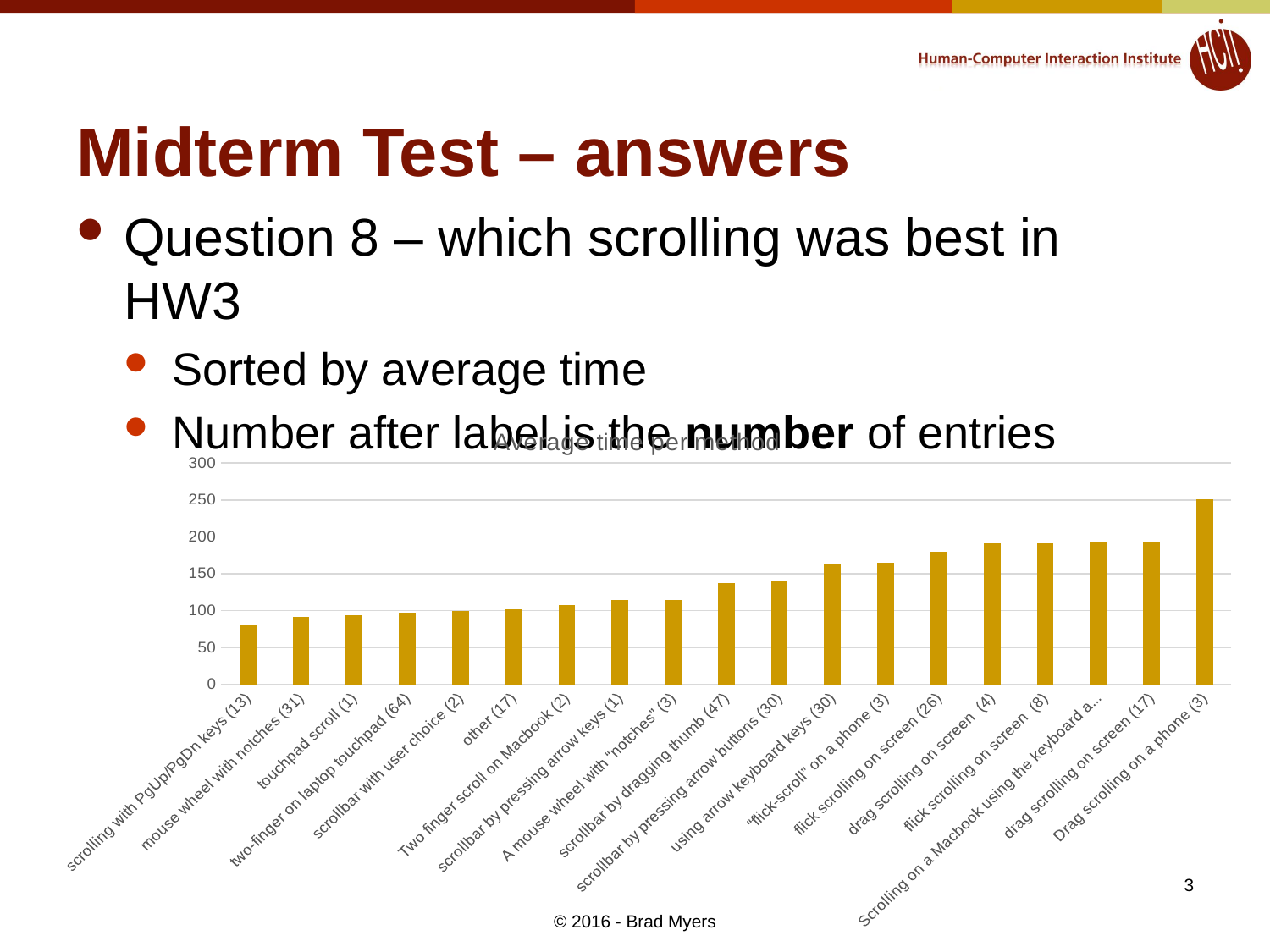
Is the value for scrollbar by dragging thumb (47) greater or less than 150? less Do the bar values rise or fall from left to right along the x axis? rise Which scrolling method has the lowest average time in the chart? scrolling with PgUp/PgDn keys (13) Which has the larger average time: Drag scrolling on a phone (3) or scrolling with PgUp/PgDn keys (13)? Drag scrolling on a phone (3) Is the value for scrolling with PgUp/PgDn keys (13) greater or less than 100? less Is the value for Drag scrolling on a phone (3) greater or less than 200? greater Which has the larger average time: scrollbar by dragging thumb (47) or two-finger on laptop touchpad (64)? scrollbar by dragging thumb (47) What is the title of the chart? Average time per method Which scrolling method has the highest average time in the chart? Drag scrolling on a phone (3) How many bars (scrolling methods) are plotted in the chart? 19 What kind of chart is shown on the slide? bar chart